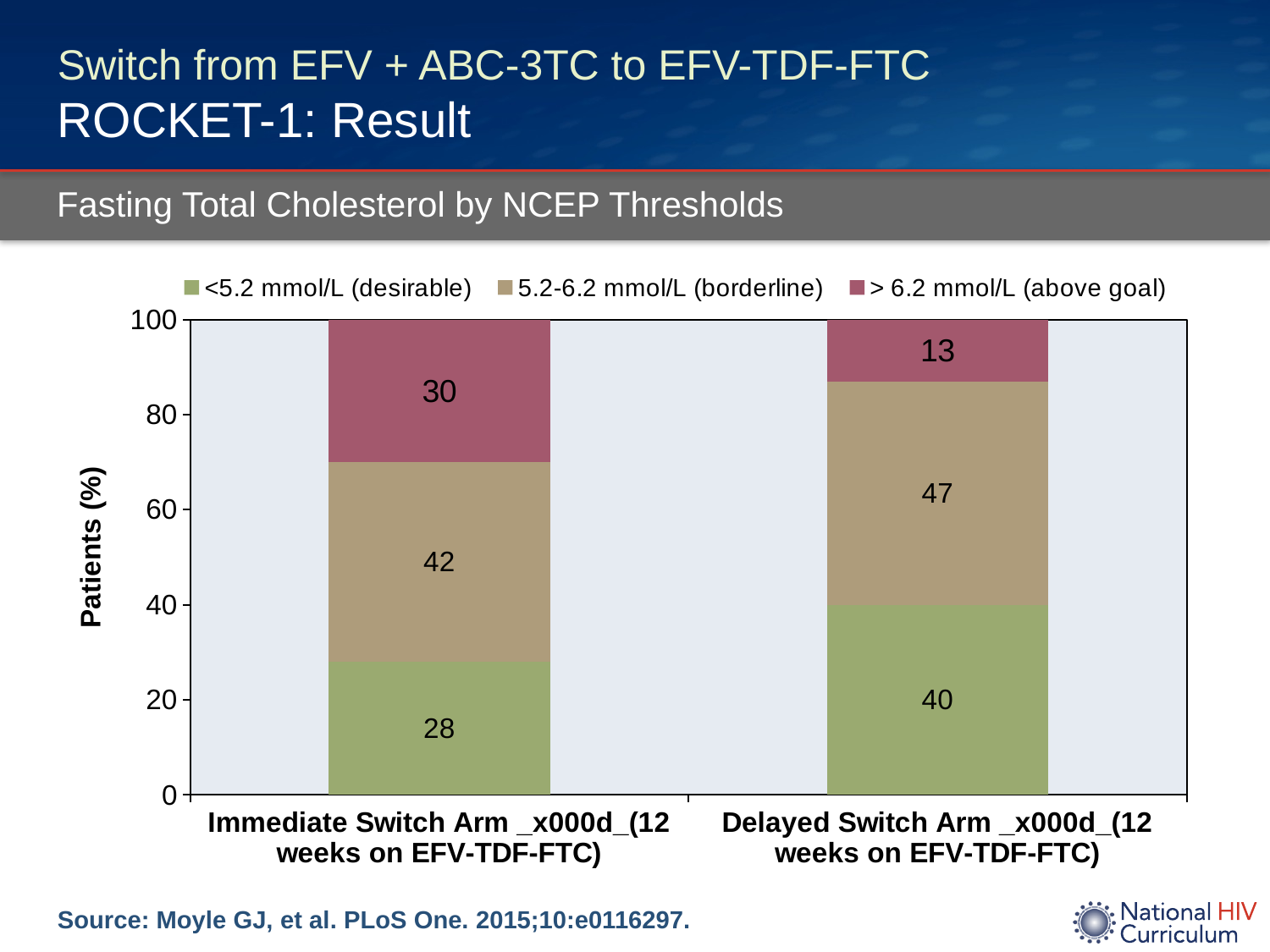
Which arm has the higher percentage of patients with total cholesterol > 6.2 mmol/L (above goal)? Immediate Switch Arm How many categories (arms) are shown on the x axis? 2 What is the total of the stacked bar for the Immediate Switch Arm? 100 What kind of chart is shown on the slide? Stacked bar chart How many series does the legend list? 3 What is the value for the 5.2-6.2 mmol/L (borderline) category in the Delayed Switch Arm? 47 What is the value for the > 6.2 mmol/L (above goal) category in the Immediate Switch Arm? 30 What percentage of patients in the Delayed Switch Arm had total cholesterol > 6.2 mmol/L (above goal)? 13 What is the difference between the Delayed Switch Arm and the Immediate Switch Arm in the percentage of patients with <5.2 mmol/L (desirable) cholesterol? 12 What is the label of the y axis? Patients (%) What is the difference between the Immediate Switch Arm and the Delayed Switch Arm in the percentage of patients with > 6.2 mmol/L (above goal) cholesterol? 17 What percentage of patients in the Immediate Switch Arm had total cholesterol <5.2 mmol/L (desirable)? 28